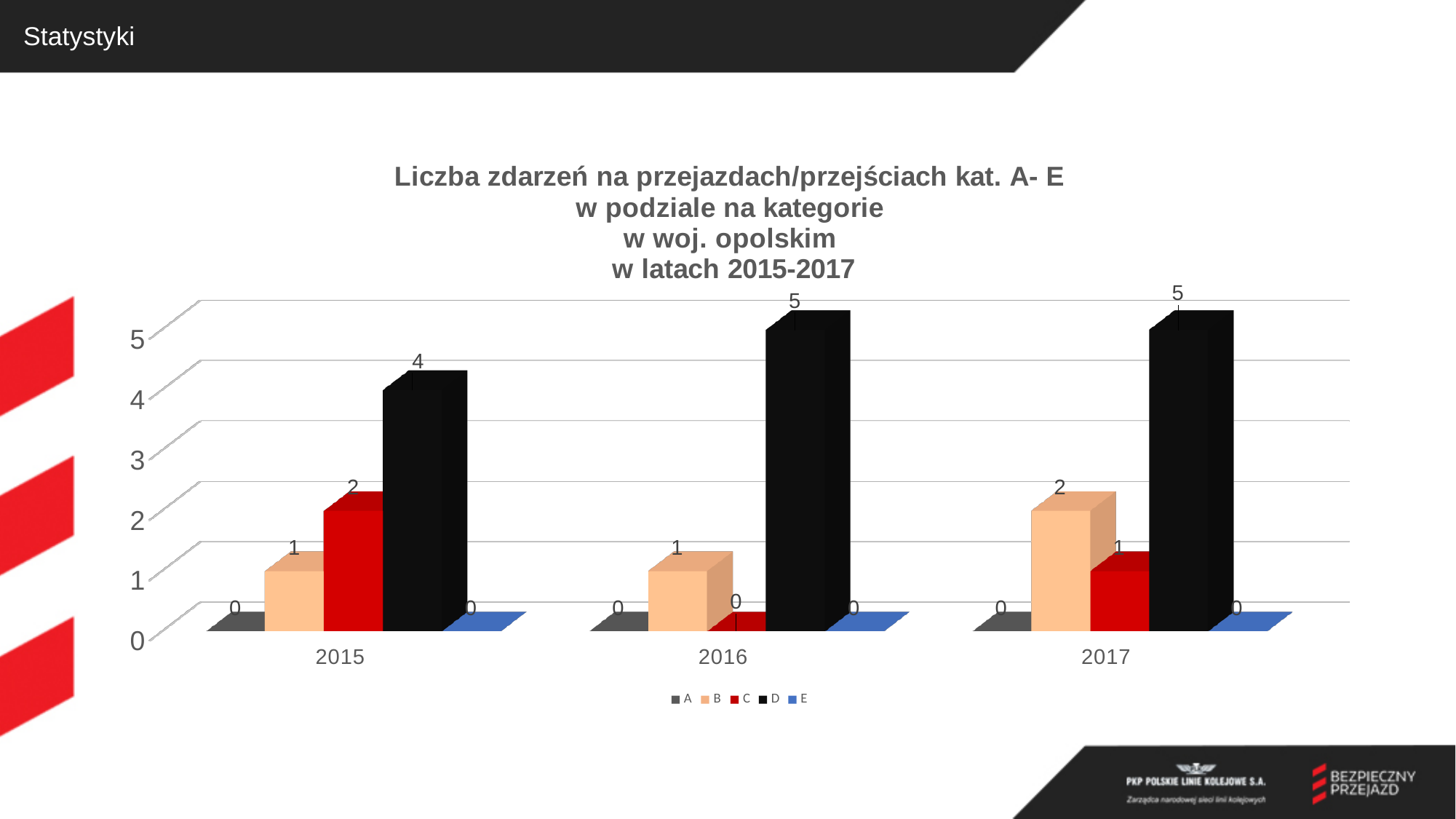
How many years are shown on the x axis? 3 What is the value for category B in 2017? 2 What is the difference between the value for D in 2016 and the value for D in 2015? 1 What is the value for category D in 2015? 4 What kind of chart is shown on the slide? bar chart Which category has the highest value in 2016? D Which is larger: the value for B in 2017 or the value for B in 2015? B in 2017 What is the value for category C in 2015? 2 What colour are the bars for category D? black What is the value for category C in 2016? 0 Does the value for category D rise or fall from 2015 to 2016? rise How many series does the legend list? 5